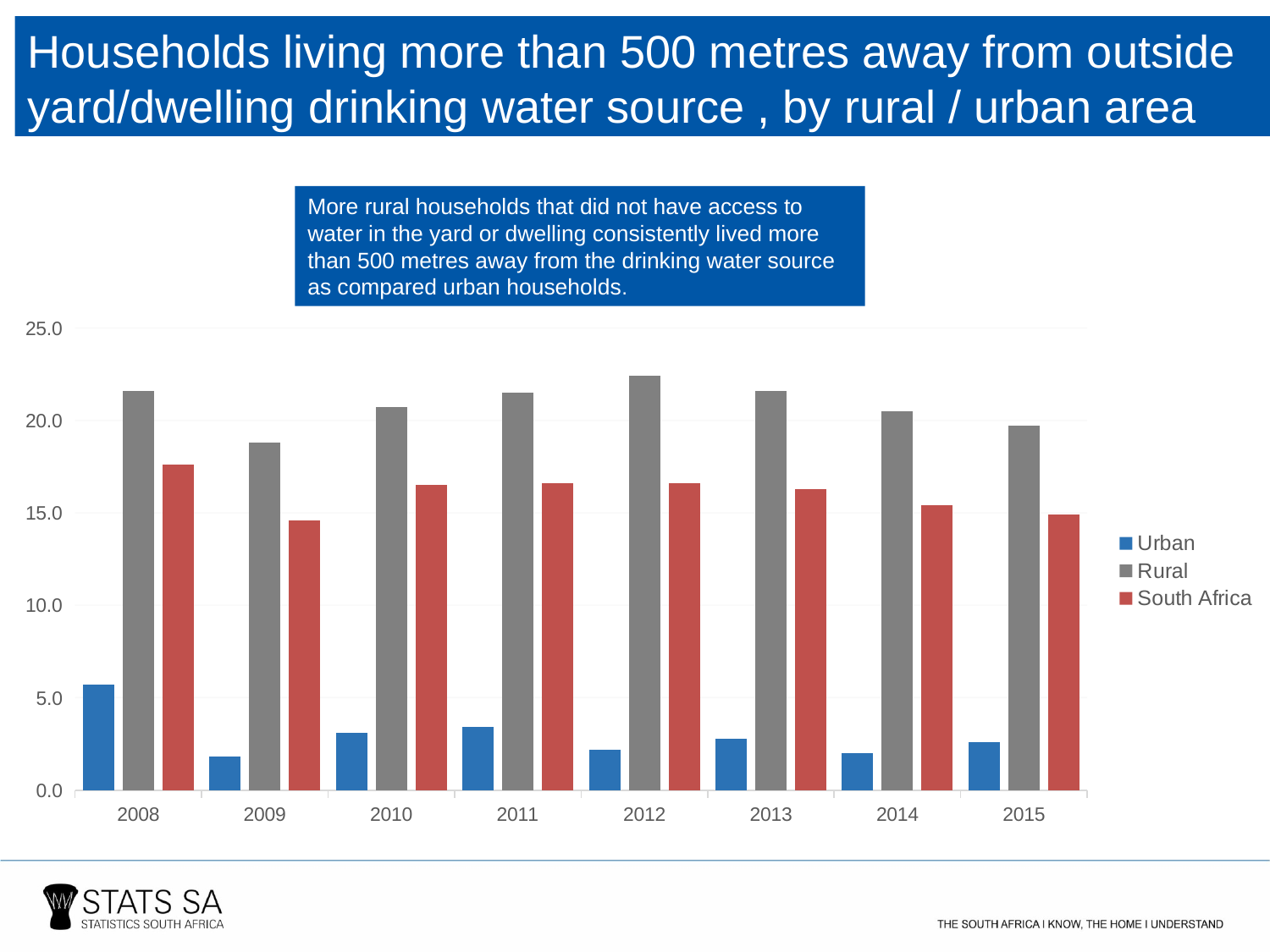
Is the South Africa value for 2009 greater or less than 15.0? less How many years are shown on the x axis? 8 What kind of chart is shown on the slide? bar chart In which year is the Rural value lowest? 2009 In which year is the Rural value highest? 2012 In which year is the South Africa value highest? 2008 Is the Urban value for 2008 greater or less than 5.0? greater Is the Rural value for 2012 greater or less than 20.0? greater Which is larger in 2008, the Rural value or the South Africa value? Rural In which year is the Urban value highest? 2008 How many series does the legend list? 3 Do the South Africa values rise or fall from 2012 to 2015? fall